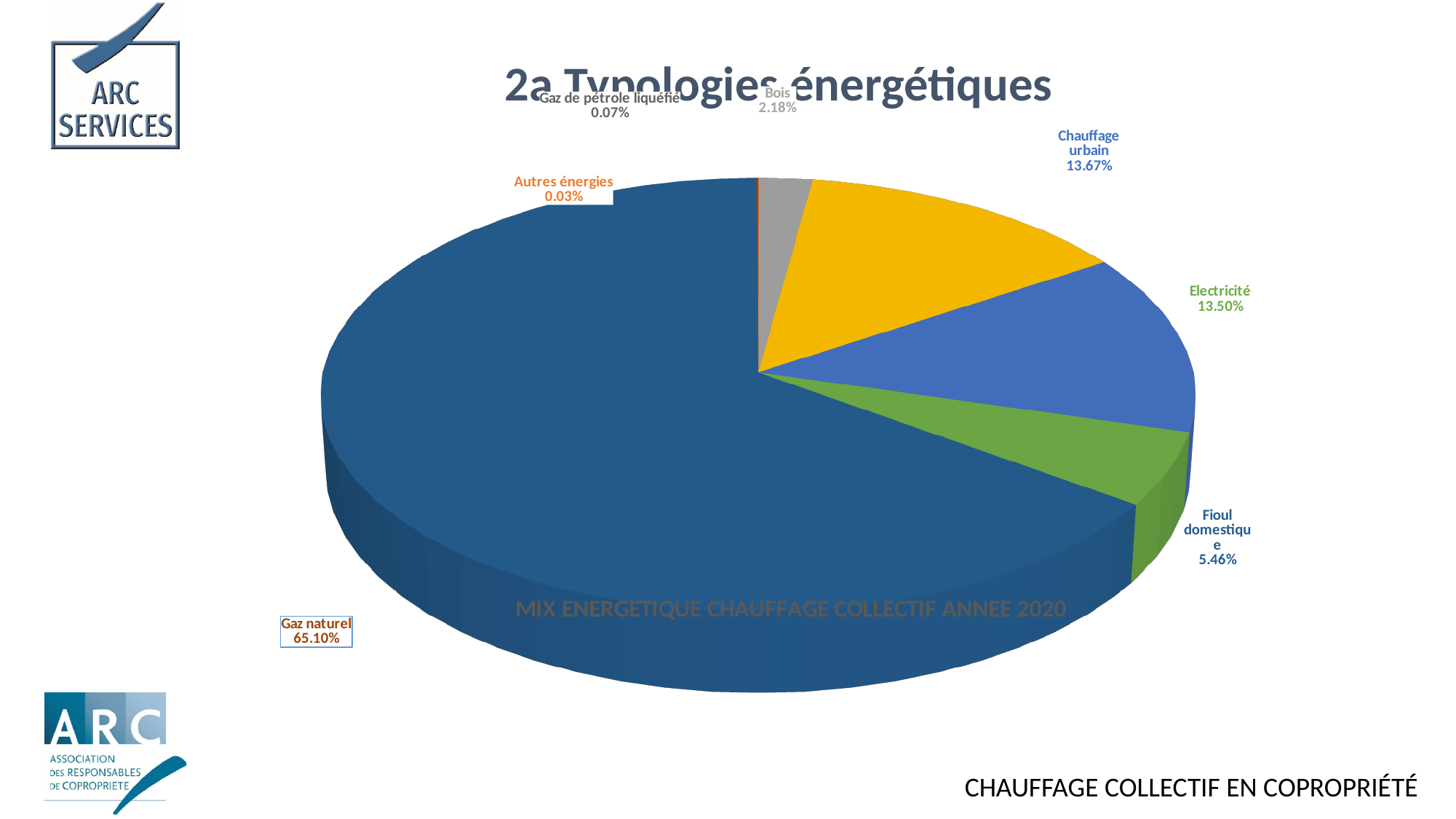
What is the difference between the values for Gaz naturel and Chauffage urbain? 51.43% What kind of chart is shown on the slide? pie chart What is the value shown for Electricité? 13.50% What is the value shown for Bois? 2.18% Which category has the largest slice of the pie? Gaz naturel Which is larger, the value for Fioul domestique or the value for Bois? Fioul domestique How many categories are shown in the pie chart? 7 Which category has the smallest slice of the pie? Autres énergies What is the value shown for Autres énergies? 0.03% What is the value shown for Fioul domestique? 5.46% What is the value shown for Chauffage urbain? 13.67% What share of the pie does Gaz naturel represent? 65.10%